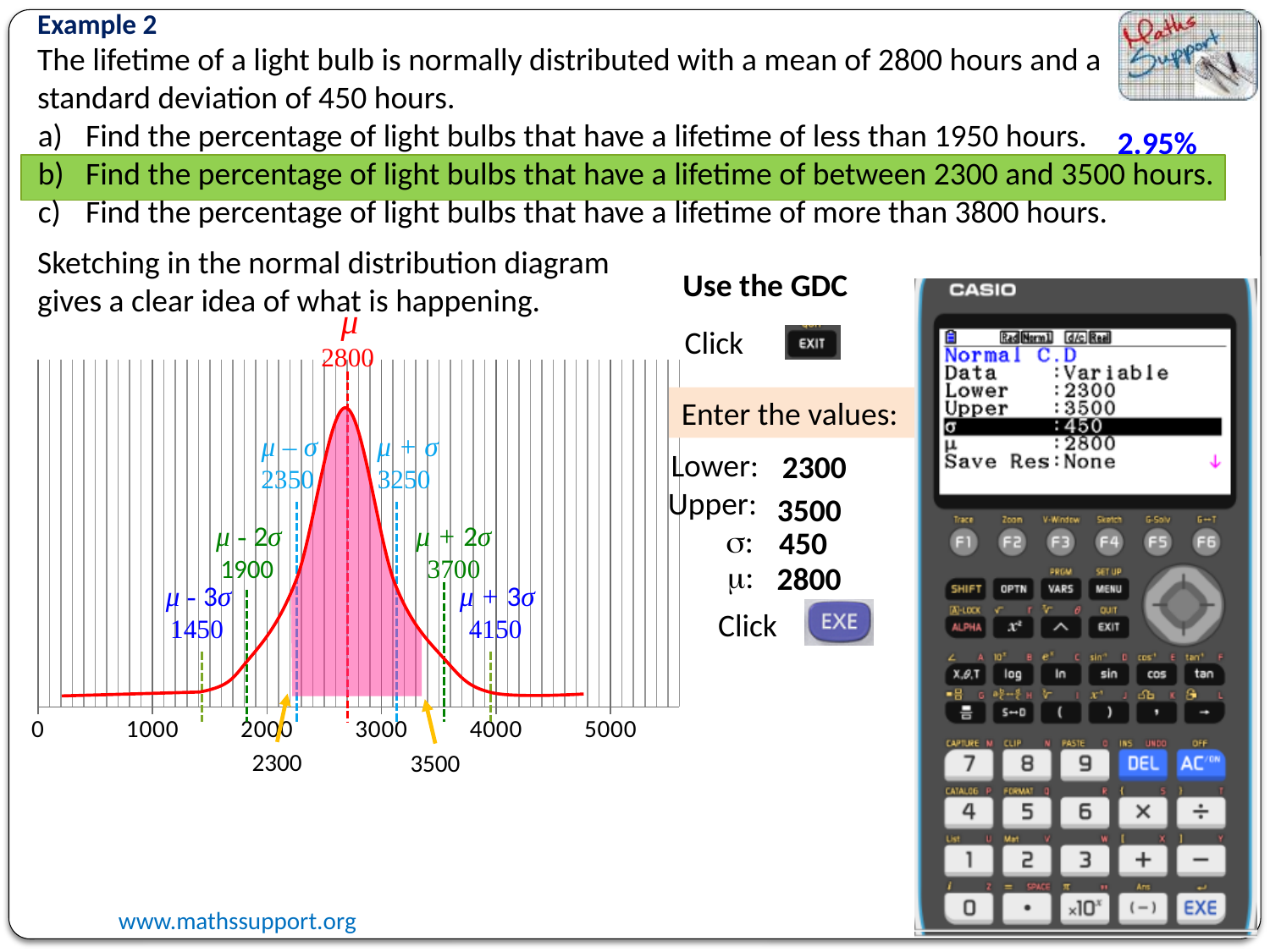
How many labelled tick values are shown on the x axis of the normal distribution diagram? 6 On the normal distribution diagram, what value is labelled at μ − σ? 2350 On the normal distribution diagram, what is the difference between the values labelled at μ + σ and μ − σ? 900 On the normal distribution diagram, what value is labelled at μ − 2σ? 1900 On the normal distribution diagram, what value is labelled at μ − 3σ? 1450 On the normal distribution diagram, what value is labelled at the mean μ? 2800 What colour is the shaded region under the curve on the normal distribution diagram? Pink On the normal distribution diagram, which is larger: the value at μ + 2σ or the value at μ + σ? μ + 2σ On the normal distribution diagram, what are the lower and upper bounds of the shaded region marked below the x axis? 2300 and 3500 On the normal distribution diagram, what value is labelled at μ + 3σ? 4150 On the normal distribution diagram, what is the difference between the values labelled at μ + 2σ and μ? 900 On the normal distribution diagram, what value is labelled at μ + σ? 3250